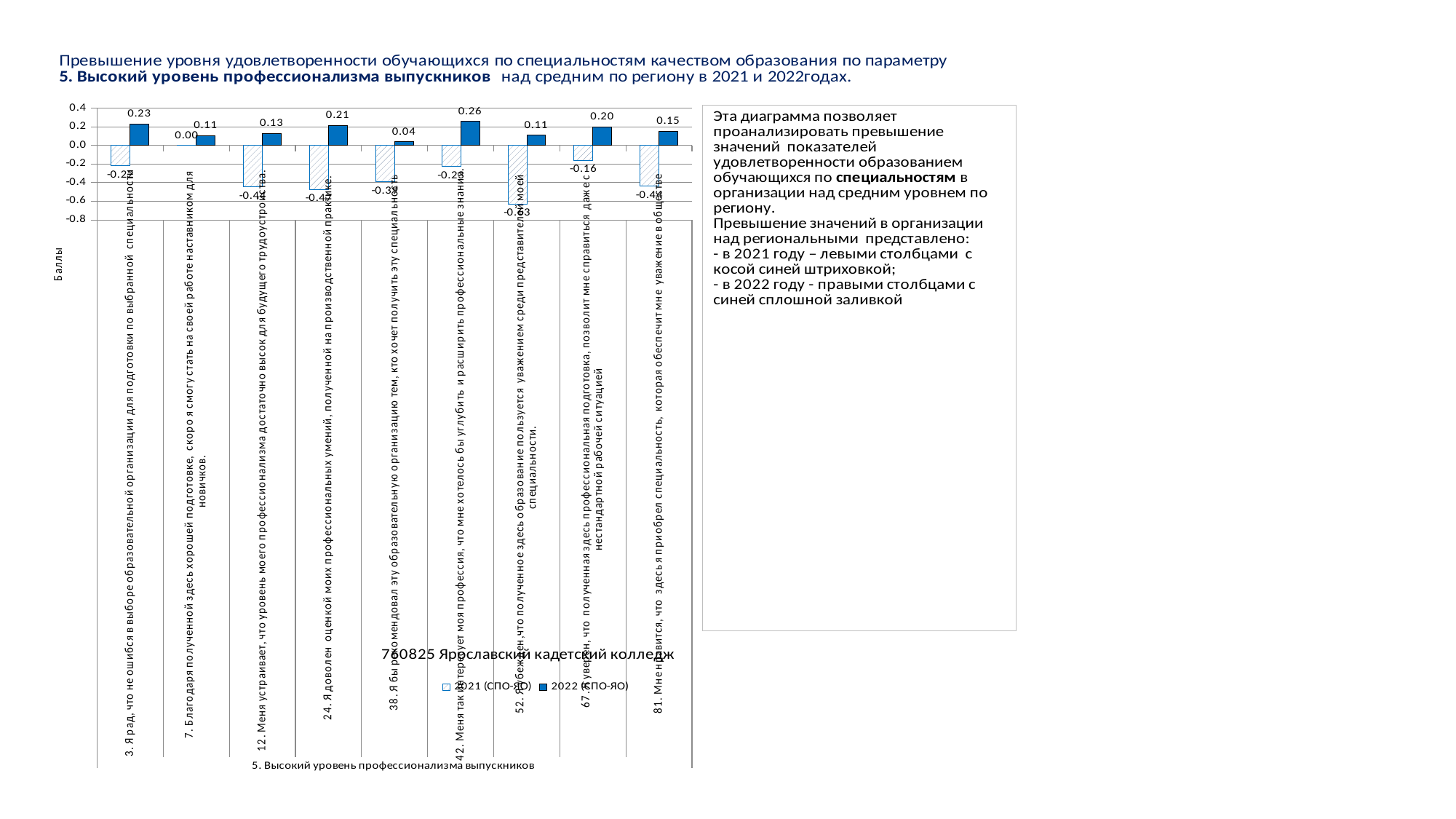
What is the 2022 (СПО-ЯО) value for statement 3 (Я рад, что не ошибся в выборе образовательной организации...)? 0.23 What kind of chart is shown on the slide? bar chart Which statement has the lowest 2021 (СПО-ЯО) value? 52. Я убежден, что полученное здесь образование пользуется уважением среди представителей моей специальности What is the title printed on the chart? 760825 Ярославский кадетский колледж Which statement has the highest 2022 (СПО-ЯО) value? 42. Меня так интересует моя профессия, что мне хотелось бы углубить и расширить профессиональные знания How many series does the chart legend list? 2 What is the 2021 (СПО-ЯО) value for statement 67 (Я уверен, что полученная здесь профессиональная подготовка...)? -0.16 What is the difference between the 2022 (СПО-ЯО) values for statement 42 and statement 38? 0.22 How many categories (survey statements) are plotted on the chart? 9 What is the 2021 (СПО-ЯО) value for statement 7 (Благодаря полученной здесь хорошей подготовке...)? 0.00 Is the 2021 (СПО-ЯО) value for statement 52 greater or less than -0.4? less Which statement has the lowest 2022 (СПО-ЯО) value? 38. Я бы рекомендовал эту образовательную организацию тем, кто хочет получить эту специальность